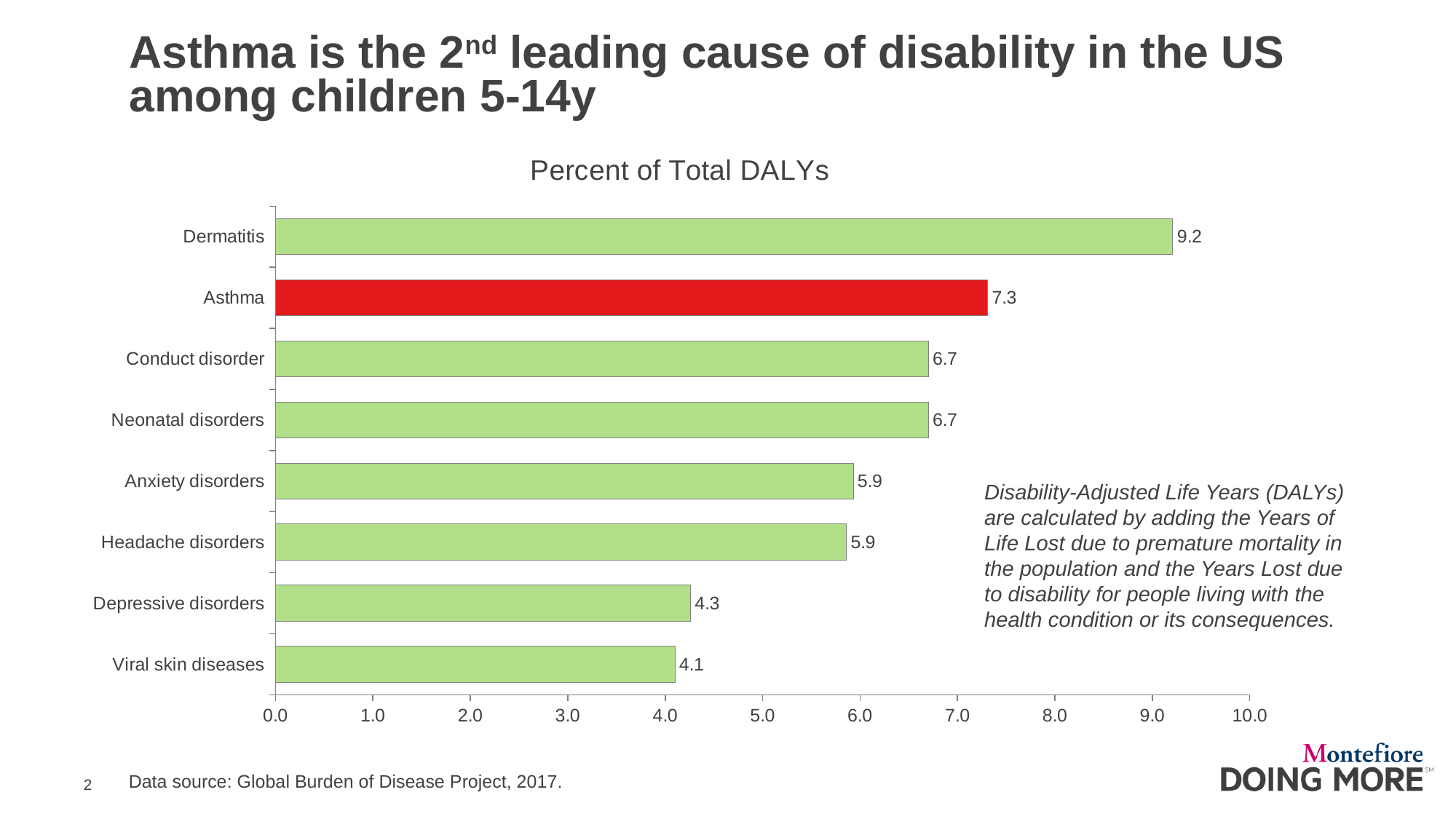
What is the value for Asthma? 7.3 What is the value for Depressive disorders? 4.3 Which is larger, the value for Asthma or the value for Conduct disorder? Asthma Which bar is coloured red? Asthma Is the value for Anxiety disorders greater or less than 5.0? greater What is the title of the chart? Percent of Total DALYs What is the value for Dermatitis? 9.2 Which category has the highest value? Dermatitis What is the difference between the values for Dermatitis and Asthma? 1.9 What kind of chart is shown on the slide? bar chart How many categories are shown in the chart? 8 Which category has the lowest value? Viral skin diseases